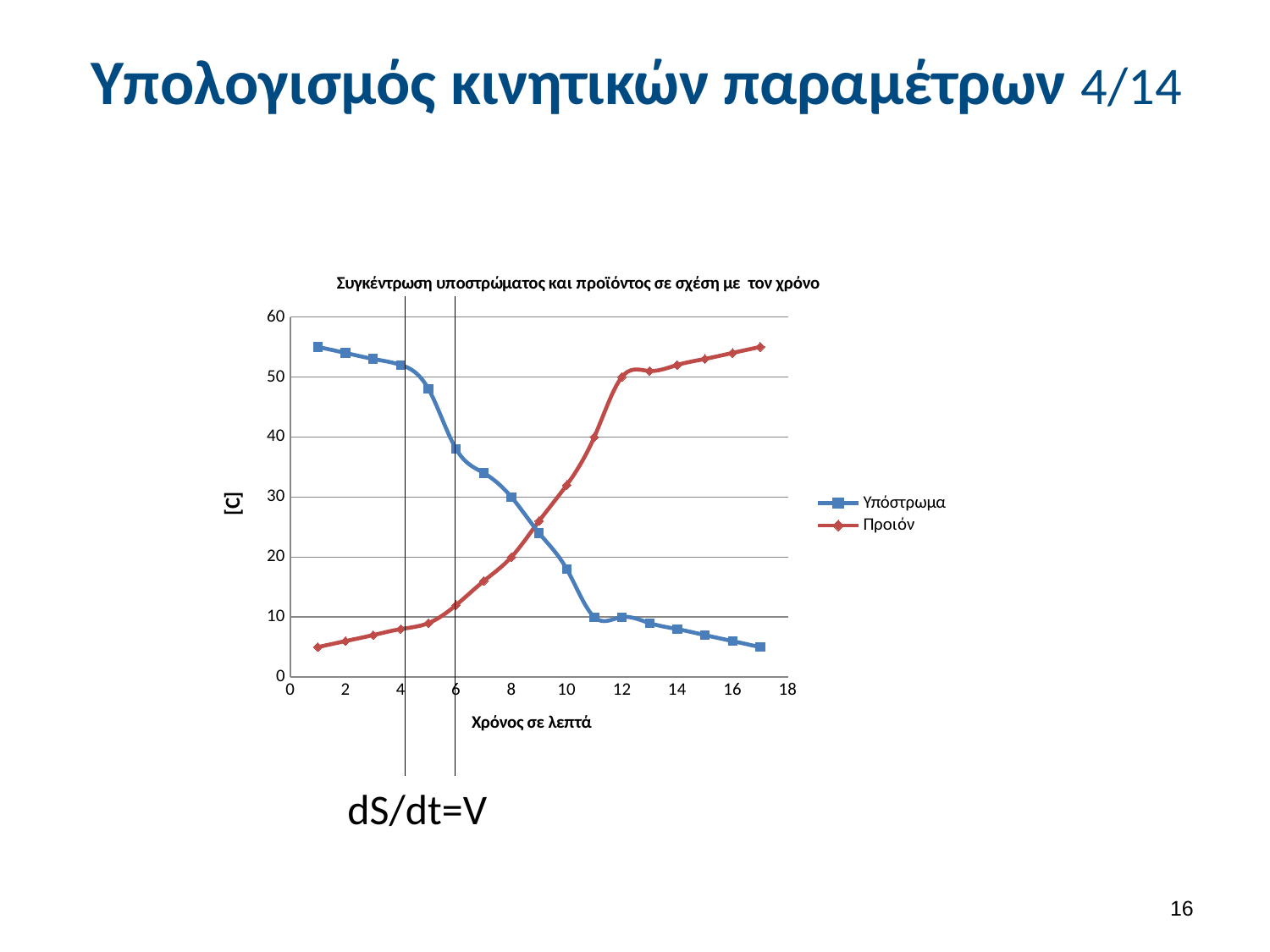
How many series does the chart legend list? 2 Does the Υπόστρωμα series rise or fall as time increases? fall Is the value of Υπόστρωμα at 16 minutes greater or less than 10? less Is the value of Προιόν at 16 minutes greater or less than 50? greater What kind of chart is shown on the slide? line chart Does the Προιόν series rise or fall as time increases? rise Is the value of Προιόν at 2 minutes greater or less than 10? less At 4 minutes, which series has the higher value, Υπόστρωμα or Προιόν? Υπόστρωμα What is the label of the x axis of the chart? Χρόνος σε λεπτά What is the title of the chart? Συγκέντρωση υποστρώματος και προϊόντος σε σχέση με τον χρόνο At 14 minutes, which series has the higher value, Υπόστρωμα or Προιόν? Προιόν